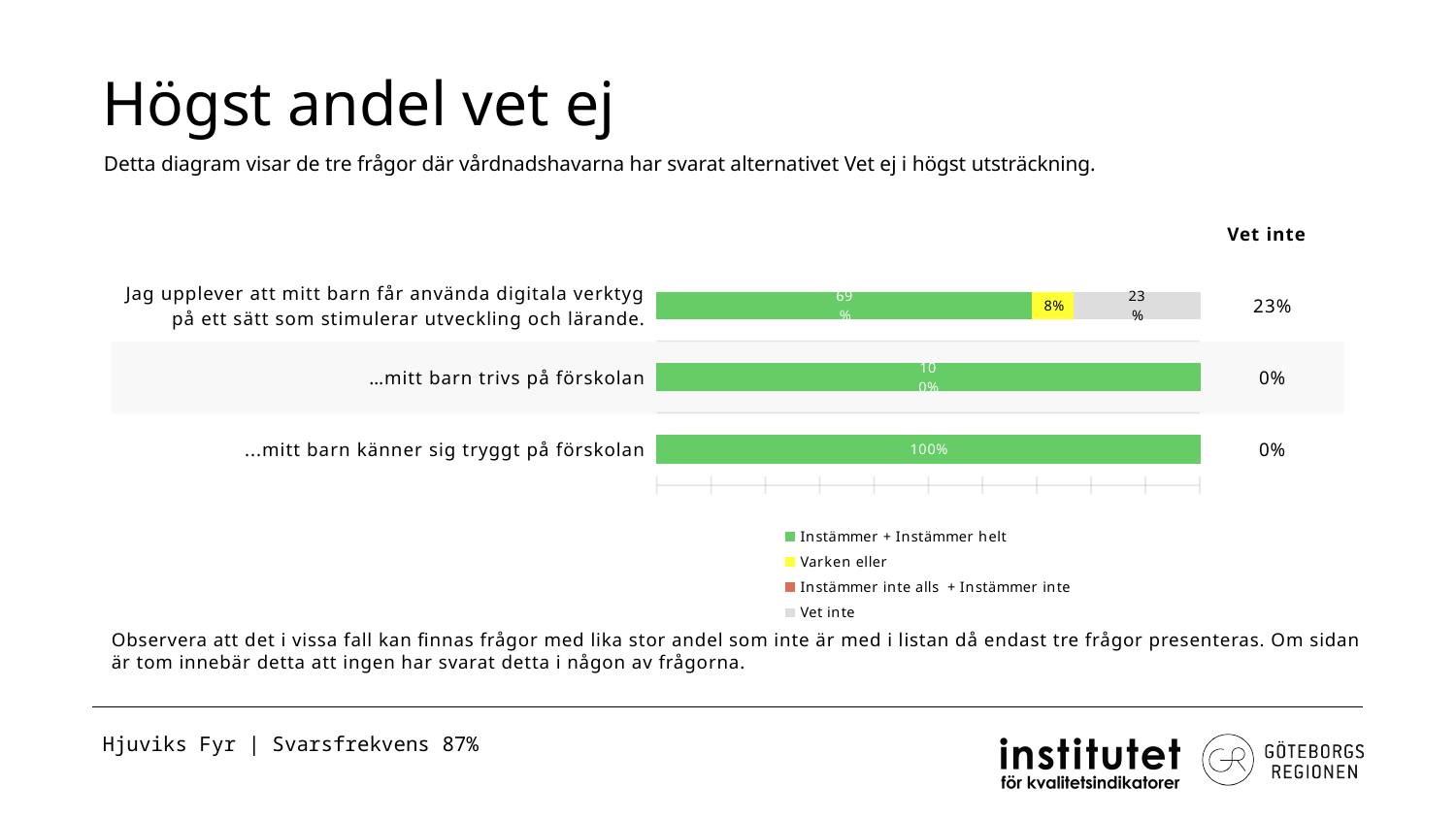
What is the 'Vet inte' value shown for 'Jag upplever att mitt barn får använda digitala verktyg på ett sätt som stimulerar utveckling och lärande'? 23% What kind of chart is shown on the slide? bar chart What is the title of the slide containing the chart? Högst andel vet ej How many questions (categories) are plotted in the chart? 3 Which question has the highest 'Vet inte' share? Jag upplever att mitt barn får använda digitala verktyg på ett sätt som stimulerar utveckling och lärande Which is larger for the digital tools question: the 'Varken eller' share or the 'Vet inte' share? Vet inte What is the 'Instämmer + Instämmer helt' share for 'Jag upplever att mitt barn får använda digitala verktyg på ett sätt som stimulerar utveckling och lärande'? 69% What is the 'Vet inte' value shown for '…mitt barn trivs på förskolan'? 0% What is the 'Varken eller' share for 'Jag upplever att mitt barn får använda digitala verktyg på ett sätt som stimulerar utveckling och lärande'? 8% How many series does the legend list? 4 What is the 'Instämmer + Instämmer helt' share for '...mitt barn känner sig tryggt på förskolan'? 100% What is the difference between the 'Instämmer + Instämmer helt' share and the 'Vet inte' share for 'Jag upplever att mitt barn får använda digitala verktyg på ett sätt som stimulerar utveckling och lärande'? 46%